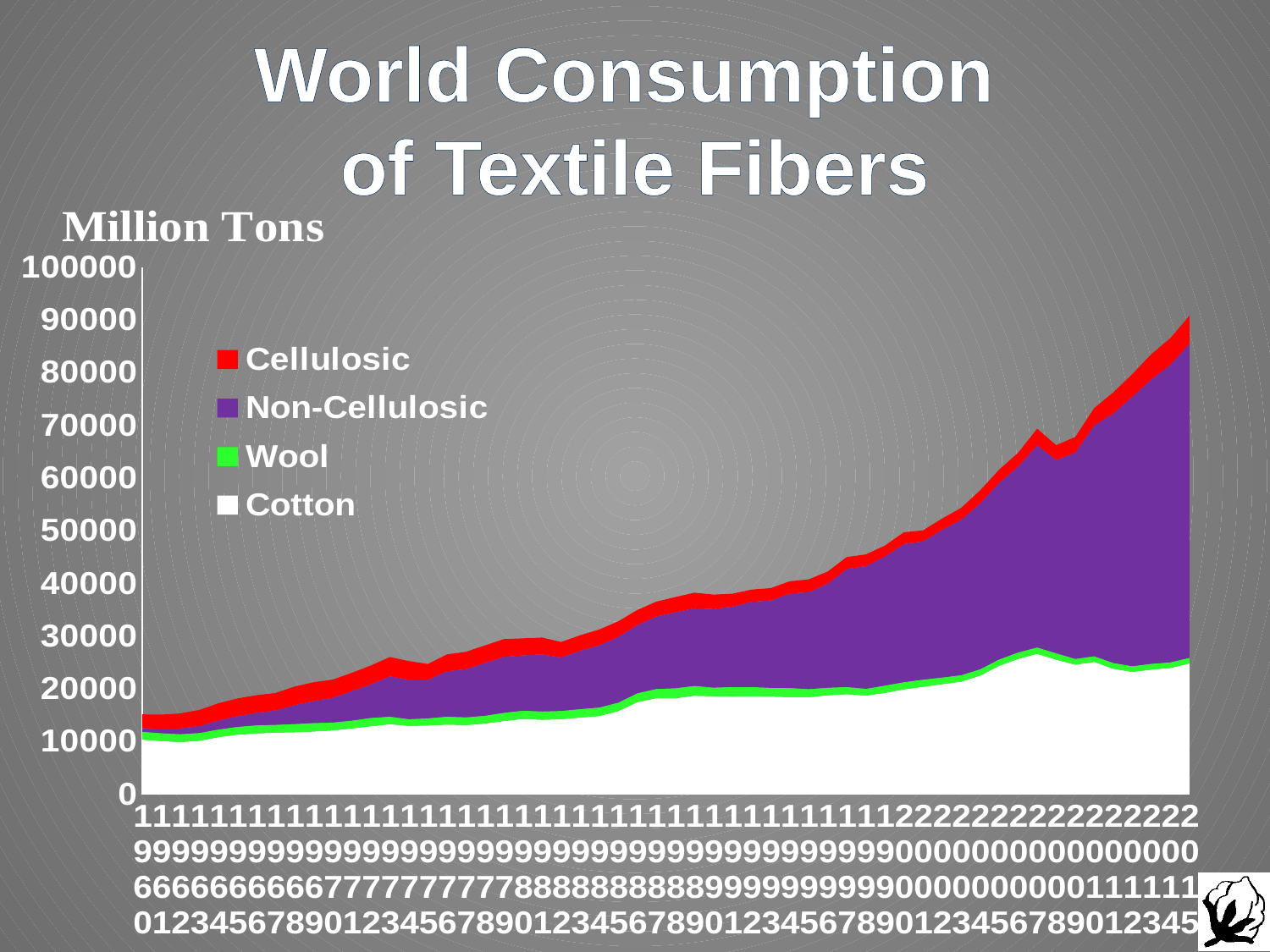
Which series accounts for the largest share of consumption in 2015? Non-Cellulosic Is the Cotton value in 2015 greater or less than 30000? less What kind of chart is shown on the slide? Stacked area chart Does total fiber consumption generally rise or fall from 1960 to 2015? Rise What is the first year shown on the x axis? 1960 Is the total consumption in 2015 greater or less than 80000? greater What is the title of the chart? World Consumption of Textile Fibers Which year has the highest total consumption? 2015 What unit label is shown above the vertical axis? Million Tons Is total consumption larger in 2015 or in 1960? 2015 How many series does the legend list? 4 Is the total consumption in 1960 greater or less than 20000? less